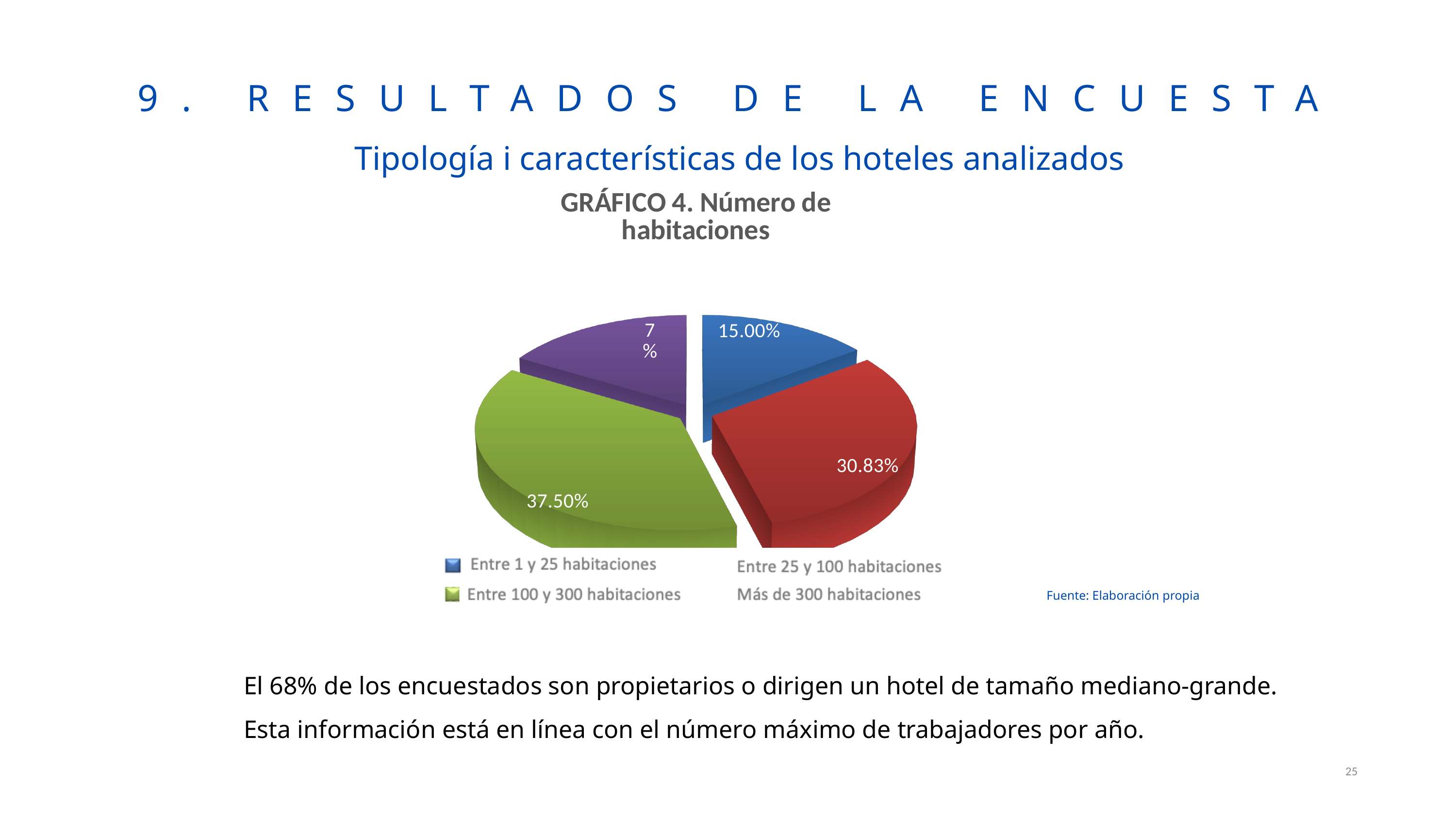
What colour is the slice for 'Entre 1 y 25 habitaciones' in the pie chart? Blue How many categories does the pie chart GRÁFICO 4 show? 4 Which slice is larger: 'Entre 25 y 100 habitaciones' or 'Entre 1 y 25 habitaciones'? Entre 25 y 100 habitaciones What kind of chart is GRÁFICO 4. Número de habitaciones? Pie chart What percentage of the pie chart corresponds to 'Entre 25 y 100 habitaciones'? 30.83% What percentage of the pie chart corresponds to 'Entre 1 y 25 habitaciones'? 15.00% What is the title of the pie chart on the slide? GRÁFICO 4. Número de habitaciones What percentage of the pie chart corresponds to 'Entre 100 y 300 habitaciones'? 37.50% Which slice is larger: 'Entre 100 y 300 habitaciones' or 'Entre 25 y 100 habitaciones'? Entre 100 y 300 habitaciones What is the difference in percentage points between 'Entre 100 y 300 habitaciones' and 'Entre 25 y 100 habitaciones'? 6.67% Which category has the largest slice in the pie chart? Entre 100 y 300 habitaciones What is the difference in percentage points between 'Entre 100 y 300 habitaciones' and 'Entre 1 y 25 habitaciones'? 22.50%